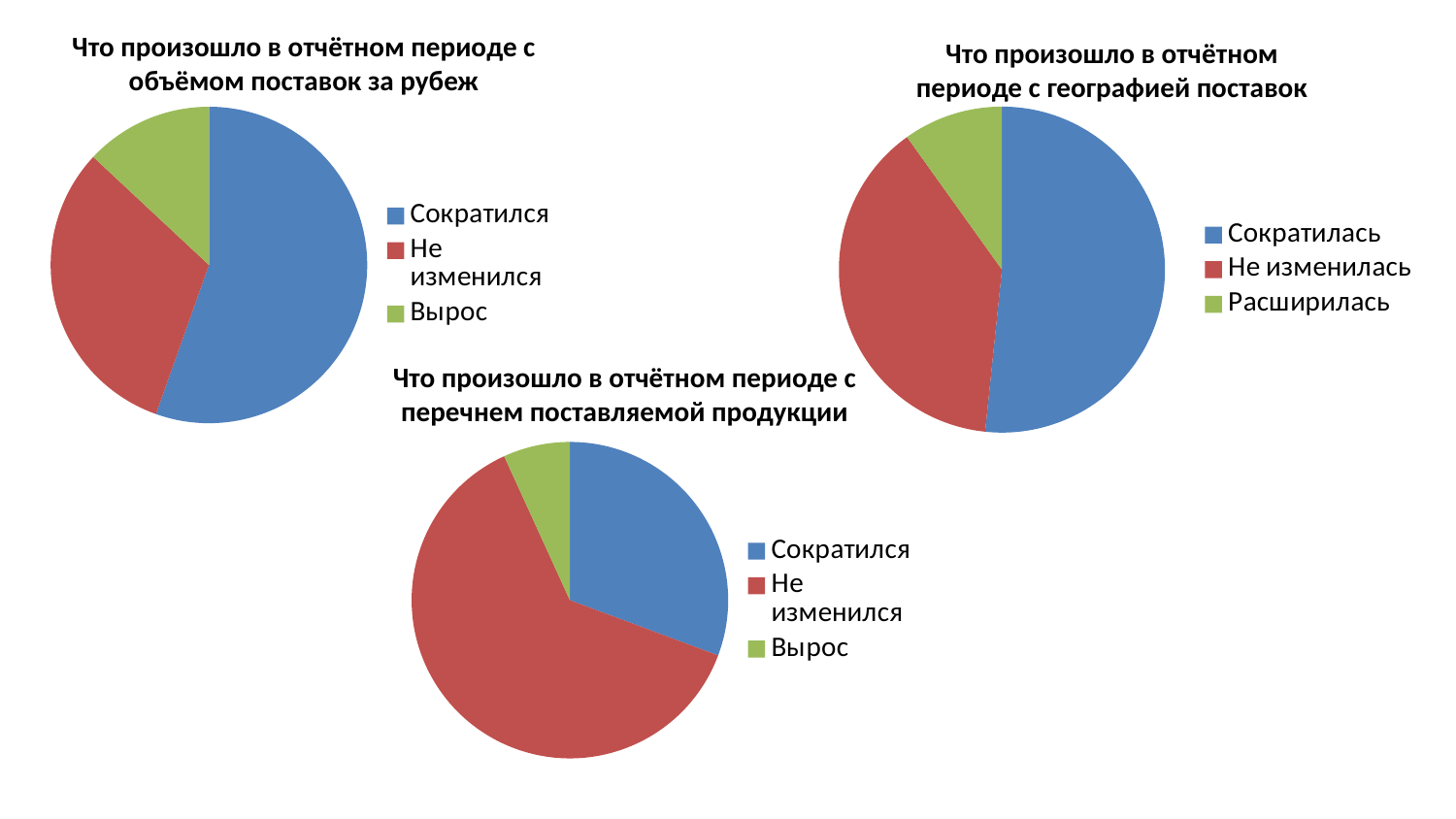
How many categories does the legend of 'Что произошло в отчётном периоде с объёмом поставок за рубеж' list? 3 In the chart 'Что произошло в отчётном периоде с объёмом поставок за рубеж', which category has the smallest slice? Вырос How many charts are on the slide? 3 In the chart 'Что произошло в отчётном периоде с объёмом поставок за рубеж', which category has the largest slice? Сократился In the chart 'Что произошло в отчётном периоде с географией поставок', which category has the largest slice? Сократилась In the chart 'Что произошло в отчётном периоде с перечнем поставляемой продукции', which category has the smallest slice? Вырос In the chart 'Что произошло в отчётном периоде с перечнем поставляемой продукции', which slice is larger: 'Сократился' or 'Не изменился'? Не изменился In the chart 'Что произошло в отчётном периоде с географией поставок', which category has the smallest slice? Расширилась In the chart 'Что произошло в отчётном периоде с географией поставок', what colour is the 'Не изменилась' slice? red In the chart 'Что произошло в отчётном периоде с географией поставок', which slice is larger: 'Сократилась' or 'Расширилась'? Сократилась In the chart 'Что произошло в отчётном периоде с перечнем поставляемой продукции', which category has the largest slice? Не изменился What kind of chart is 'Что произошло в отчётном периоде с объёмом поставок за рубеж'? pie chart